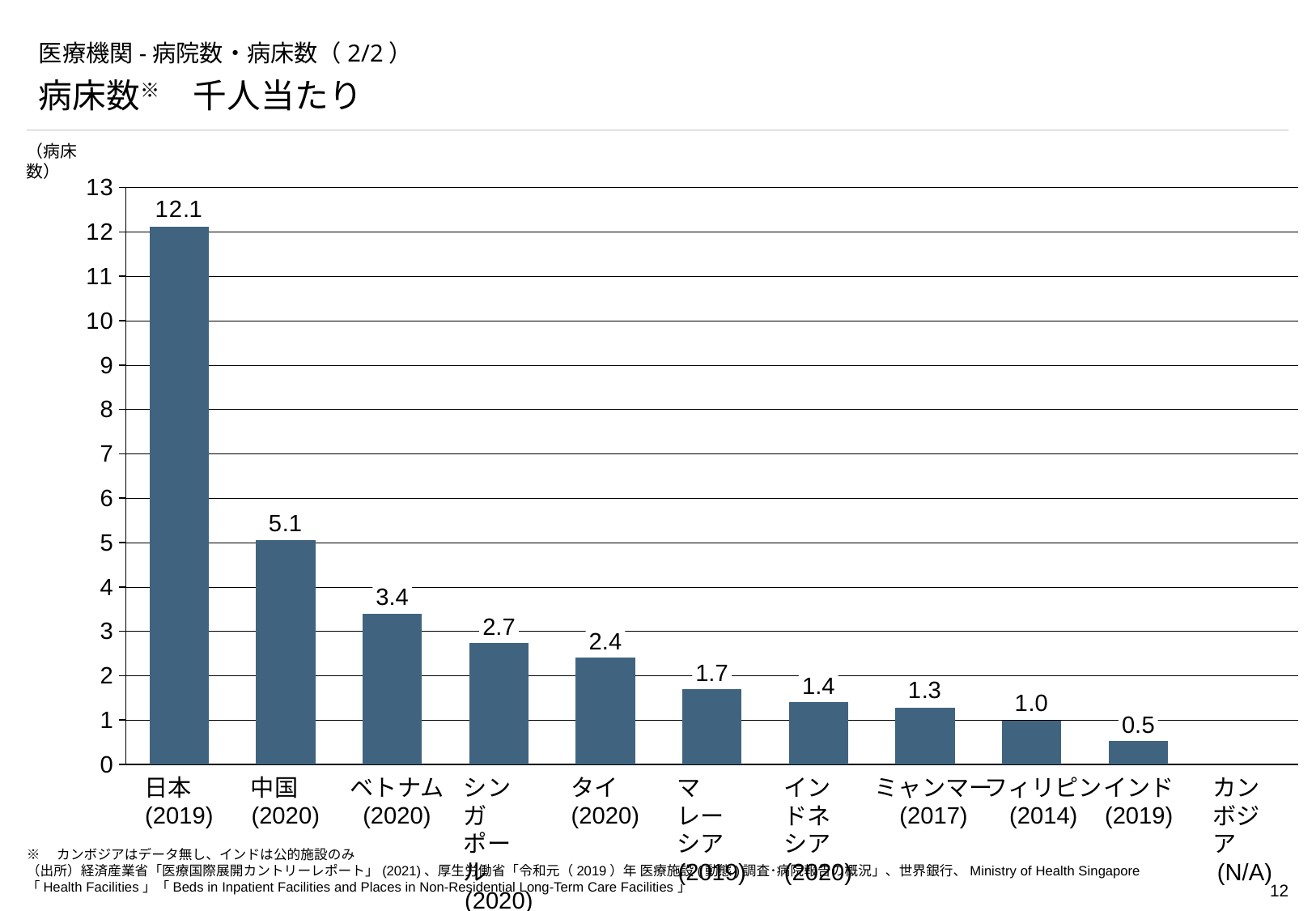
Which country on the x axis has no data shown (N/A)? カンボジア What is the difference between the values for 日本 (2019) and 中国 (2020)? 7.0 Which is larger, the value for マレーシア (2019) or インドネシア (2020)? マレーシア (2019) Is the value for 中国 (2020) greater or less than 5? greater What kind of chart is shown on the slide? bar chart Among the countries with a plotted value, which has the lowest? インド (2019) What is the value for ベトナム (2020)? 3.4 Which country has the highest number of beds per thousand people? 日本 (2019) What is the value for フィリピン (2014)? 1.0 What is the difference between the values for シンガポール (2020) and タイ (2020)? 0.3 What is the value for 日本 (2019)? 12.1 How many countries are listed on the x axis? 11